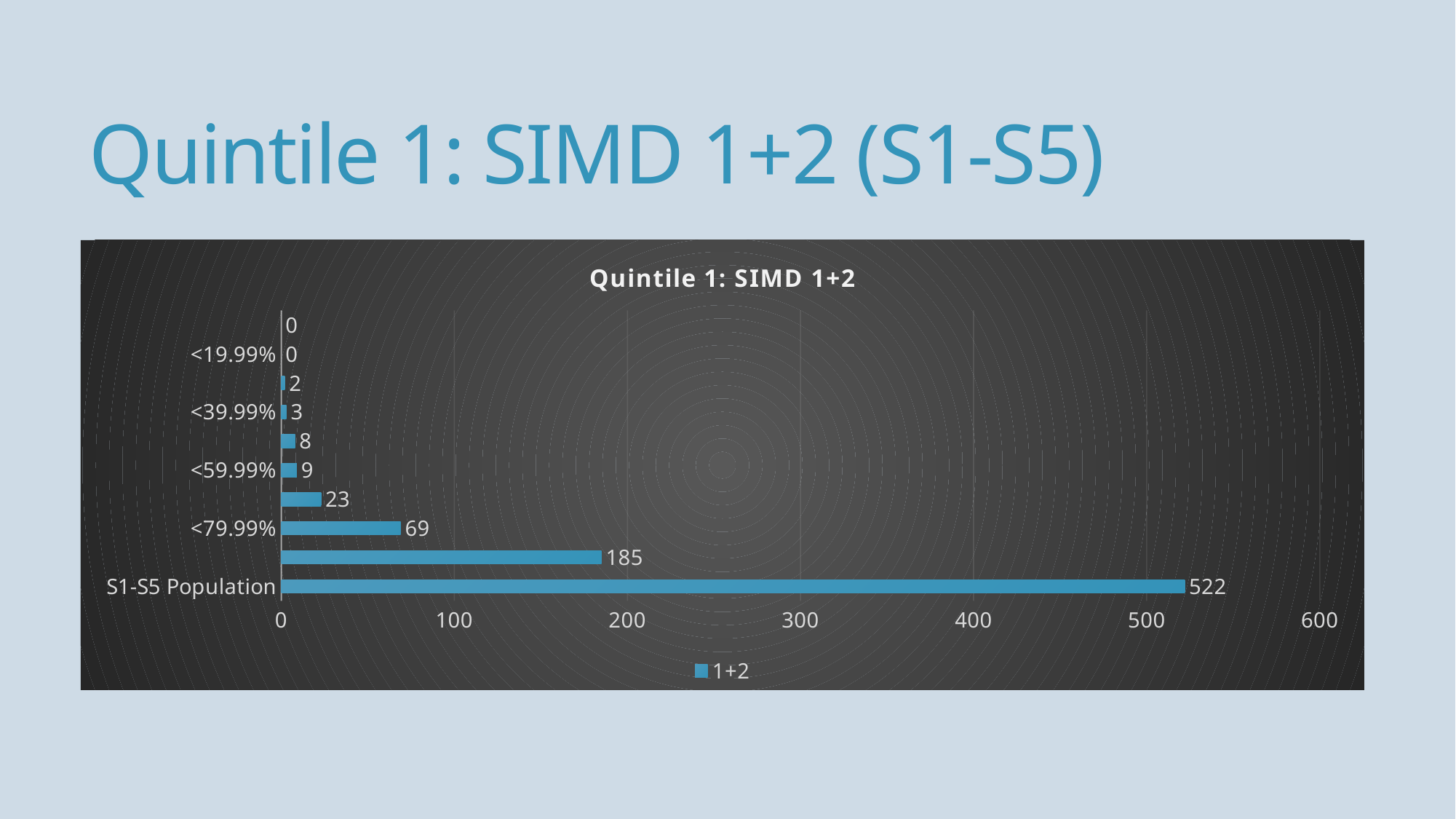
Which is larger, the value for <59.99% or the value for <39.99%? <59.99% How many series does the legend list? 1 What is the value for the <79.99% category? 69 What is the value for S1-S5 Population? 522 What is the value for the <19.99% category? 0 Which labelled category has the lowest value? <19.99% What is the value for the <59.99% category? 9 What kind of chart is shown on the slide? Bar chart Which labelled category has the highest value? S1-S5 Population How many bars are plotted in the chart? 10 What is the difference between the S1-S5 Population value and the <79.99% value? 453 What is the value for the <39.99% category? 3